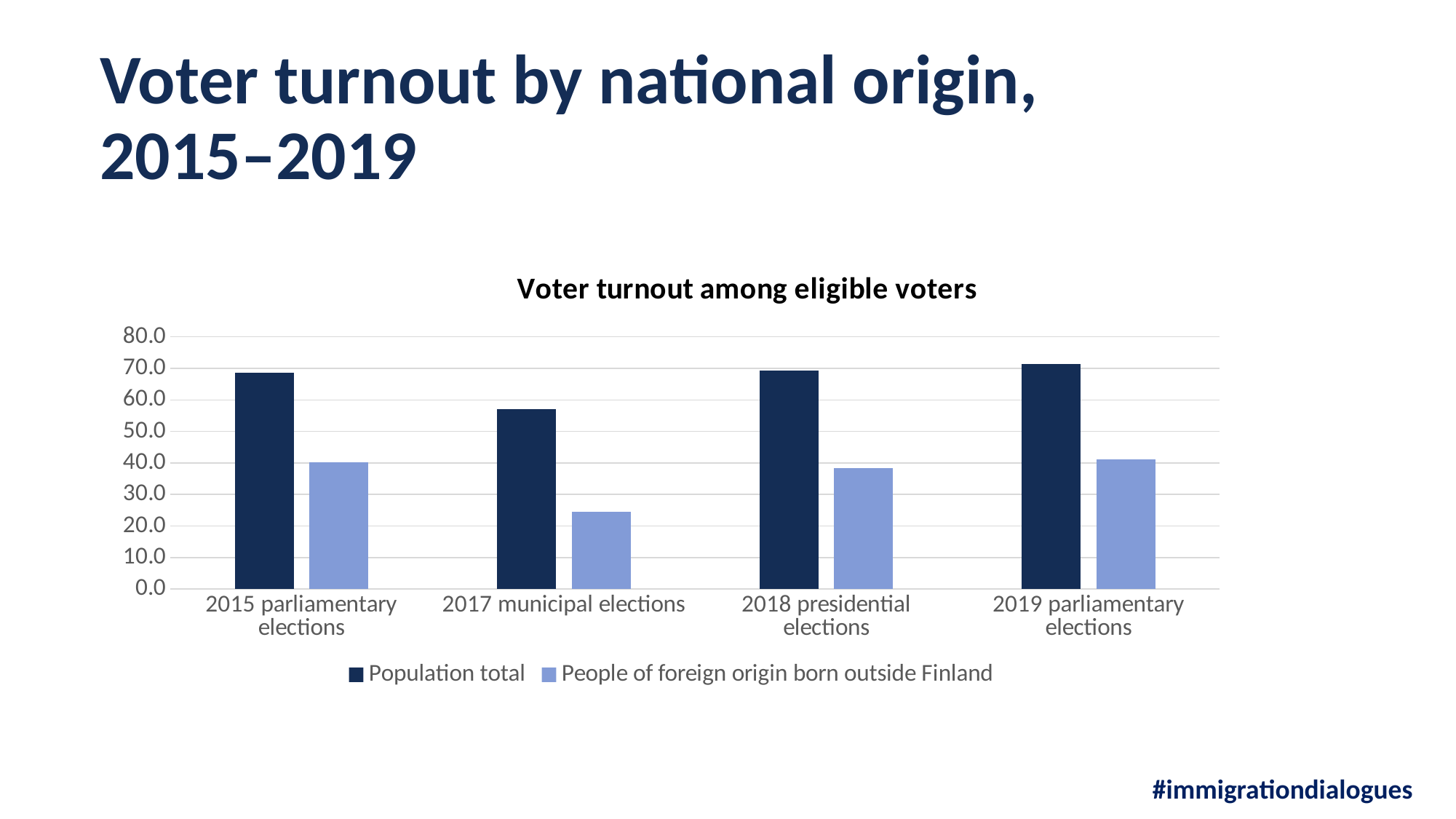
What kind of chart is shown on the slide? bar chart Is the Population total turnout for the 2017 municipal elections greater or less than 50.0? greater How many series does the legend list? 2 For which election is the turnout of People of foreign origin born outside Finland lowest? 2017 municipal elections What is the title of the chart? Voter turnout among eligible voters How many election categories are shown on the x axis? 4 Which series is shown in the lighter blue colour? People of foreign origin born outside Finland Which is larger: the turnout of People of foreign origin born outside Finland in the 2018 presidential elections or in the 2017 municipal elections? 2018 presidential elections For which election is the Population total turnout highest? 2019 parliamentary elections Is the Population total turnout for the 2015 parliamentary elections greater or less than 60.0? greater For which election is the Population total turnout lowest? 2017 municipal elections Is the turnout of People of foreign origin born outside Finland for the 2017 municipal elections greater or less than 30.0? less